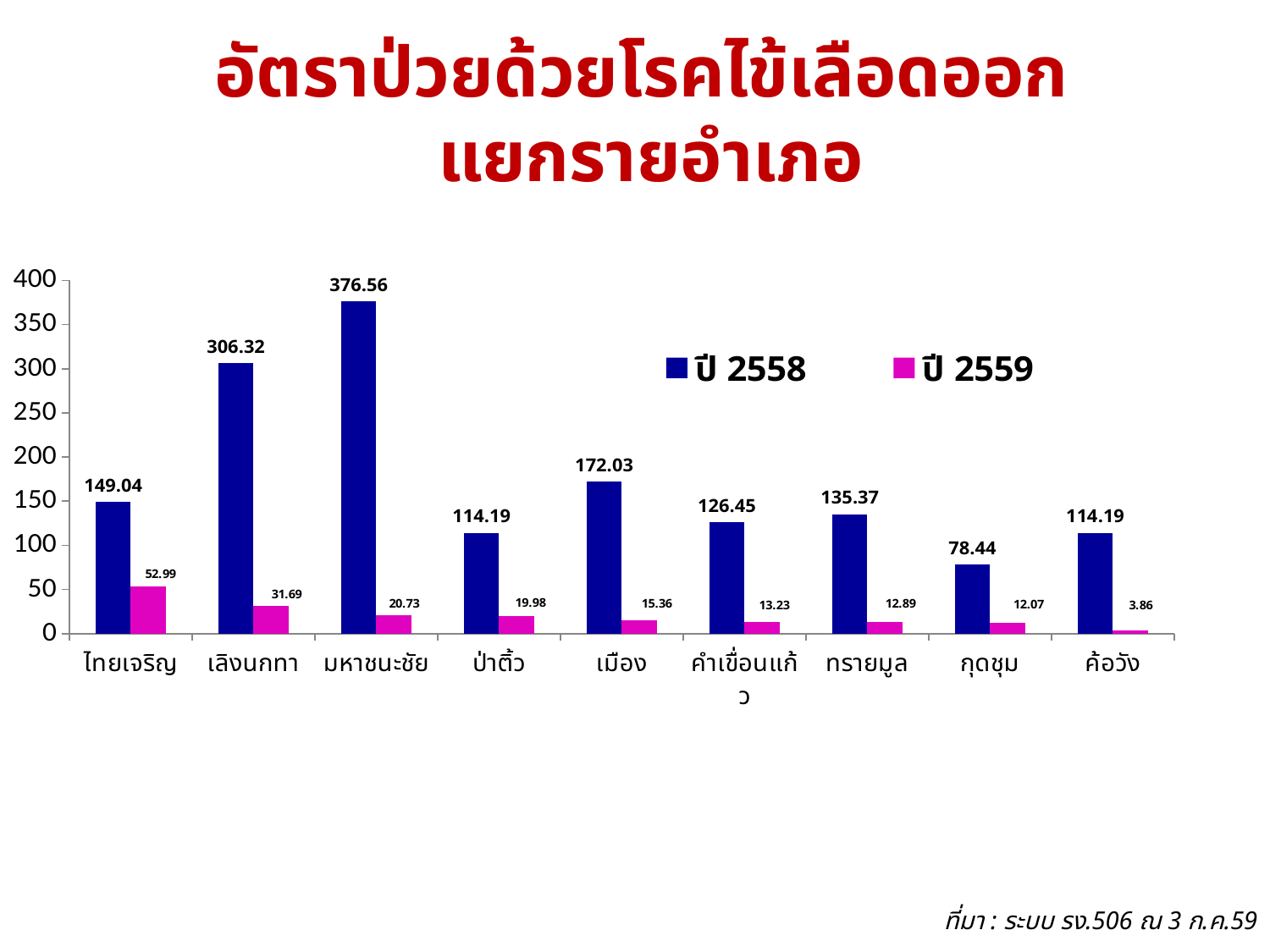
How many districts are shown on the x axis? 9 Which district has the lowest value in the ปี 2559 series? ค้อวัง What is the value for ไทยเจริญ in the ปี 2559 series? 52.99 Which district has the highest value in the ปี 2558 series? มหาชนะชัย Is the ปี 2558 value for คำเขื่อนแก้ว greater or less than 100? greater Which series is shown in magenta in the legend? ปี 2559 What is the value for กุดชุม in the ปี 2558 series? 78.44 What kind of chart is shown on the slide? bar chart How many series does the legend list? 2 What is the difference between the ปี 2558 and ปี 2559 values for เลิงนกทา? 274.63 Which is larger: the ปี 2558 value for เมือง or the ปี 2558 value for ทรายมูล? เมือง What is the value for มหาชนะชัย in the ปี 2558 series? 376.56